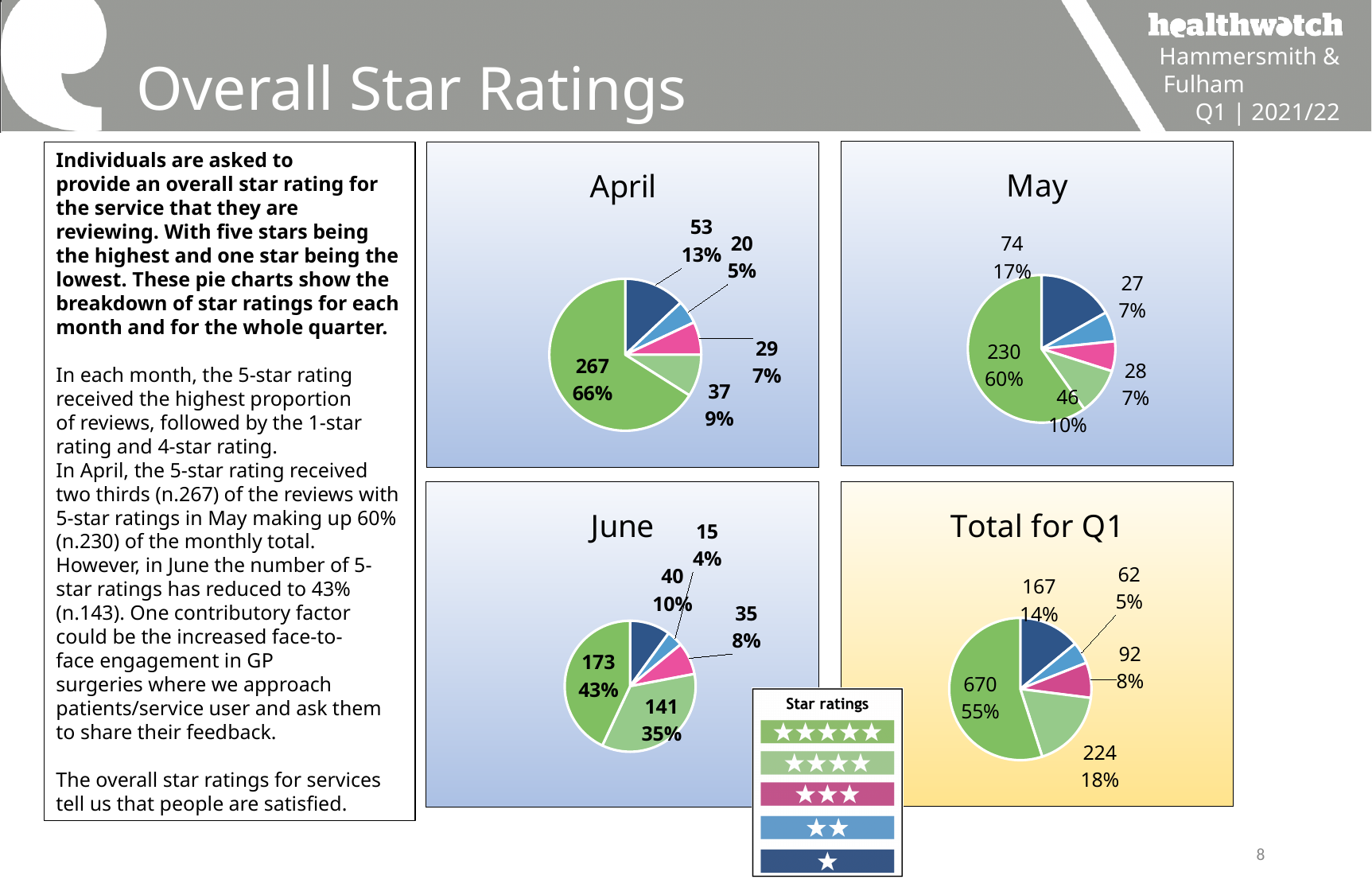
In the Total for Q1 chart, how many reviews gave a 3-star rating? 92 In the May chart, which is larger: the number of 1-star reviews or the number of 4-star reviews? 1-star reviews In the June chart, what share of reviews gave a 4-star rating? 35% In the April chart, how many reviews gave a 5-star rating? 267 In the April chart, what share of reviews gave a 1-star rating? 13% In the May chart, what percentage of reviews gave a 5-star rating? 60% In the Total for Q1 chart, what is the difference between the number of 4-star and 1-star reviews? 57 In the June chart, which star rating has the smallest slice? 2 stars How many star-rating categories does the legend list? 5 In the May chart, how many reviews gave a 4-star rating? 46 In the Total for Q1 chart, which star rating has the largest slice? 5 stars What kind of chart is used for the April data? pie chart